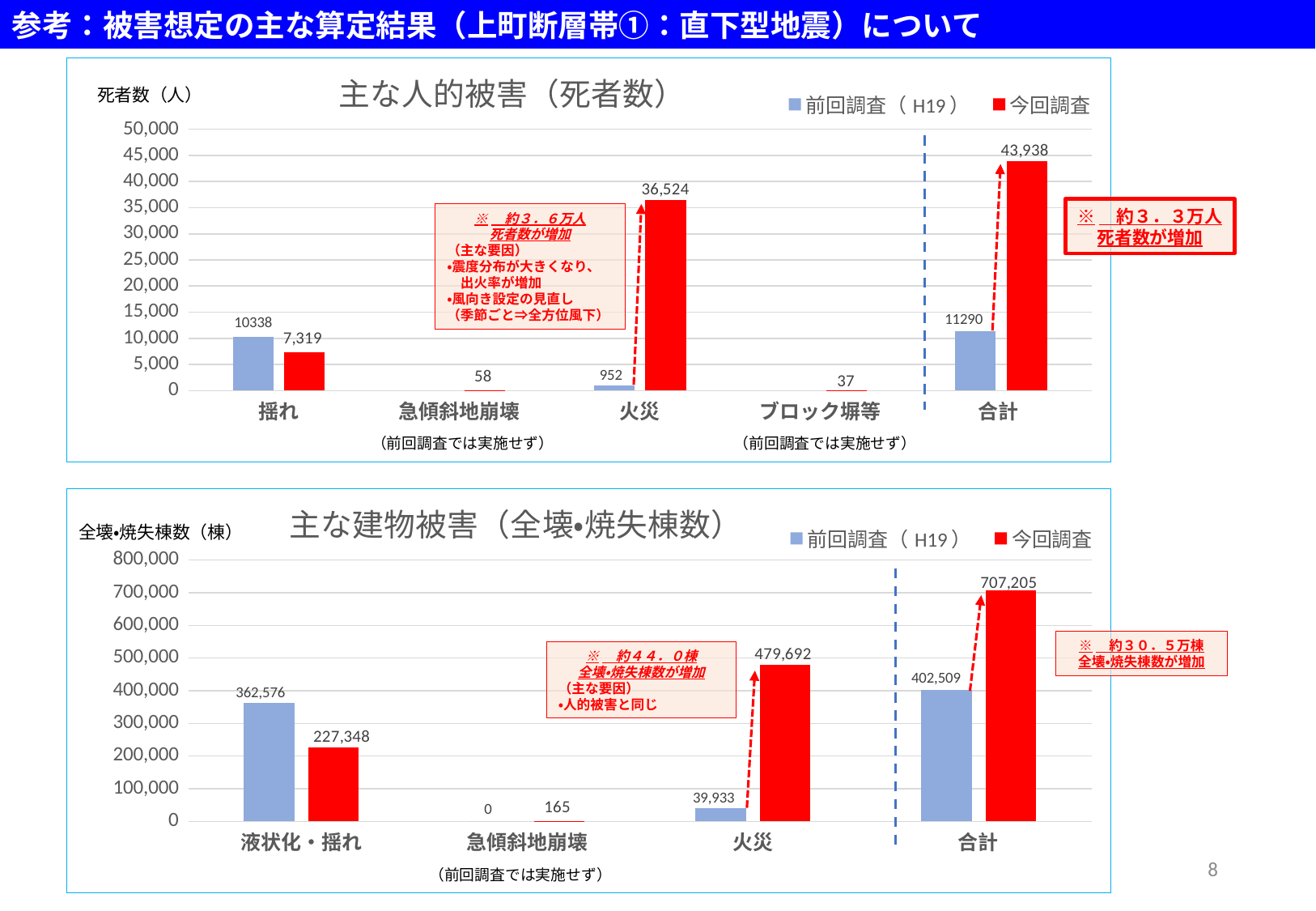
In the bottom chart 主な建物被害（全壊・焼失棟数）, what is the 今回調査 value for 火災? 479,692 In the top chart 主な人的被害（死者数）, what is the 前回調査（H19） value for 揺れ? 10338 In the bottom chart 主な建物被害（全壊・焼失棟数）, what is the 前回調査（H19） value for 合計? 402,509 In the bottom chart 主な建物被害（全壊・焼失棟数）, what is the difference between the 今回調査 and 前回調査（H19） values for 火災? 439,759 In the top chart 主な人的被害（死者数）, what is the difference between the 今回調査 and 前回調査（H19） values for 合計? 32,648 In the top chart 主な人的被害（死者数）, which category has the lowest 今回調査 value? ブロック塀等 What kind of chart is the bottom chart 主な建物被害（全壊・焼失棟数）? Bar chart In the top chart 主な人的被害（死者数）, what is the 今回調査 value for 合計? 43,938 In the bottom chart 主な建物被害（全壊・焼失棟数）, which is larger for 液状化・揺れ: the 前回調査（H19） value or the 今回調査 value? 前回調査（H19） In the top chart 主な人的被害（死者数）, what is the 今回調査 value for 火災? 36,524 In the top chart 主な人的被害（死者数）, how many series does the legend list? 2 In the bottom chart 主な建物被害（全壊・焼失棟数）, how many categories are shown on the x axis? 4